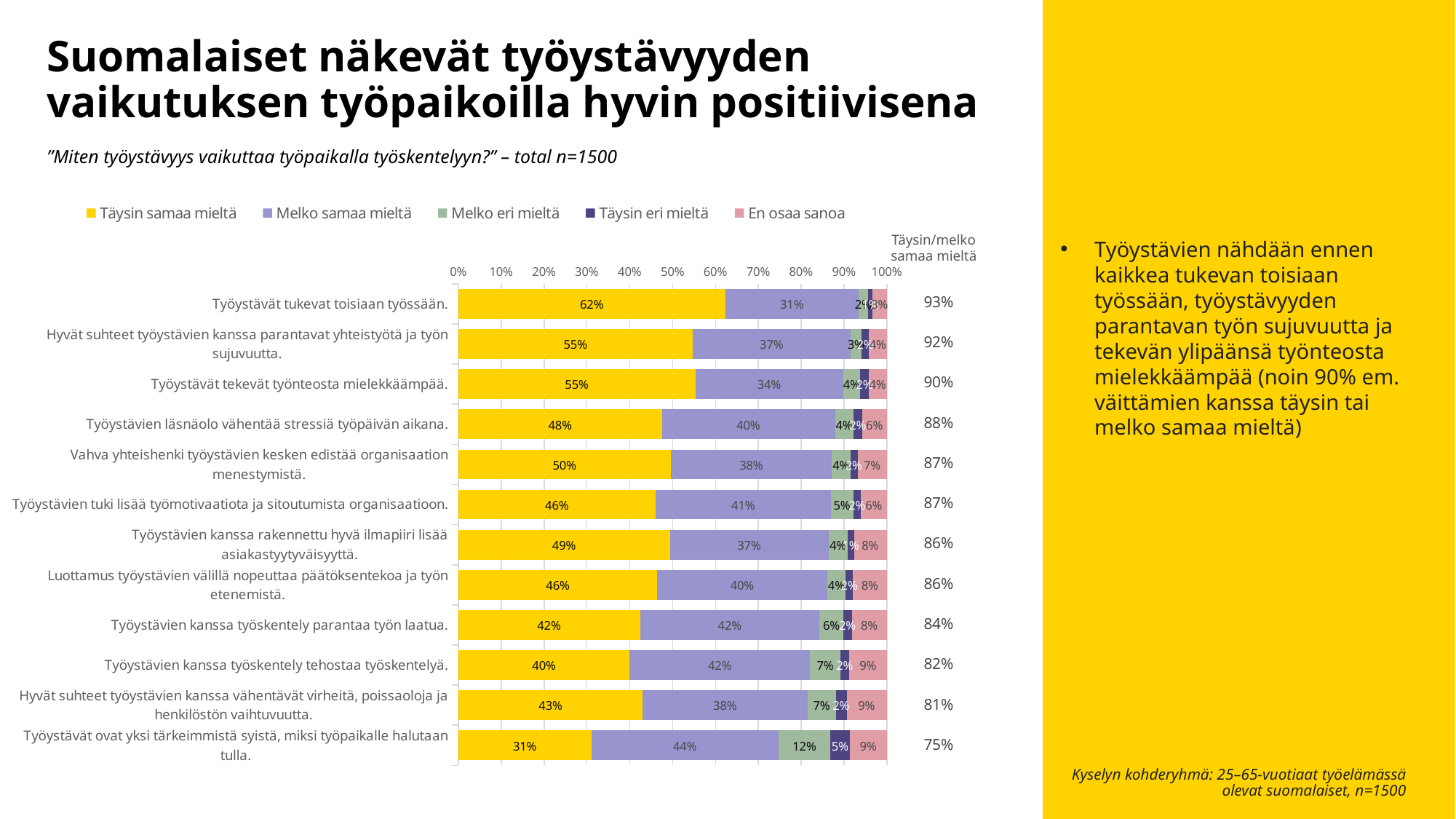
What kind of chart is shown on the slide? Stacked bar chart What is the 'Täysin samaa mieltä' value for 'Työystävät tukevat toisiaan työssään.'? 62% What is the 'En osaa sanoa' value for 'Työystävien kanssa työskentely tehostaa työskentelyä.'? 9% What is the 'Täysin/melko samaa mieltä' total shown for 'Työystävien läsnäolo vähentää stressiä työpäivän aikana.'? 88% Which statement has the highest 'Täysin samaa mieltä' share? Työystävät tukevat toisiaan työssään. What is the difference between the 'Täysin samaa mieltä' values for 'Työystävät tukevat toisiaan työssään.' (62%) and 'Työystävät ovat yksi tärkeimmistä syistä, miksi työpaikalle halutaan tulla.' (31%)? 31 percentage points What is the 'Melko samaa mieltä' value for 'Työystävät ovat yksi tärkeimmistä syistä, miksi työpaikalle halutaan tulla.'? 44% Which statement has the lowest 'Täysin/melko samaa mieltä' total? Työystävät ovat yksi tärkeimmistä syistä, miksi työpaikalle halutaan tulla. How many statements (categories) are plotted in the chart? 12 Which is larger: the 'Melko eri mieltä' value for 'Työystävät ovat yksi tärkeimmistä syistä, miksi työpaikalle halutaan tulla.' or for 'Työystävien kanssa työskentely tehostaa työskentelyä.'? Työystävät ovat yksi tärkeimmistä syistä, miksi työpaikalle halutaan tulla. (12%) What is the total sample size (n) stated in the chart subtitle? n=1500 How many series does the legend list? 5